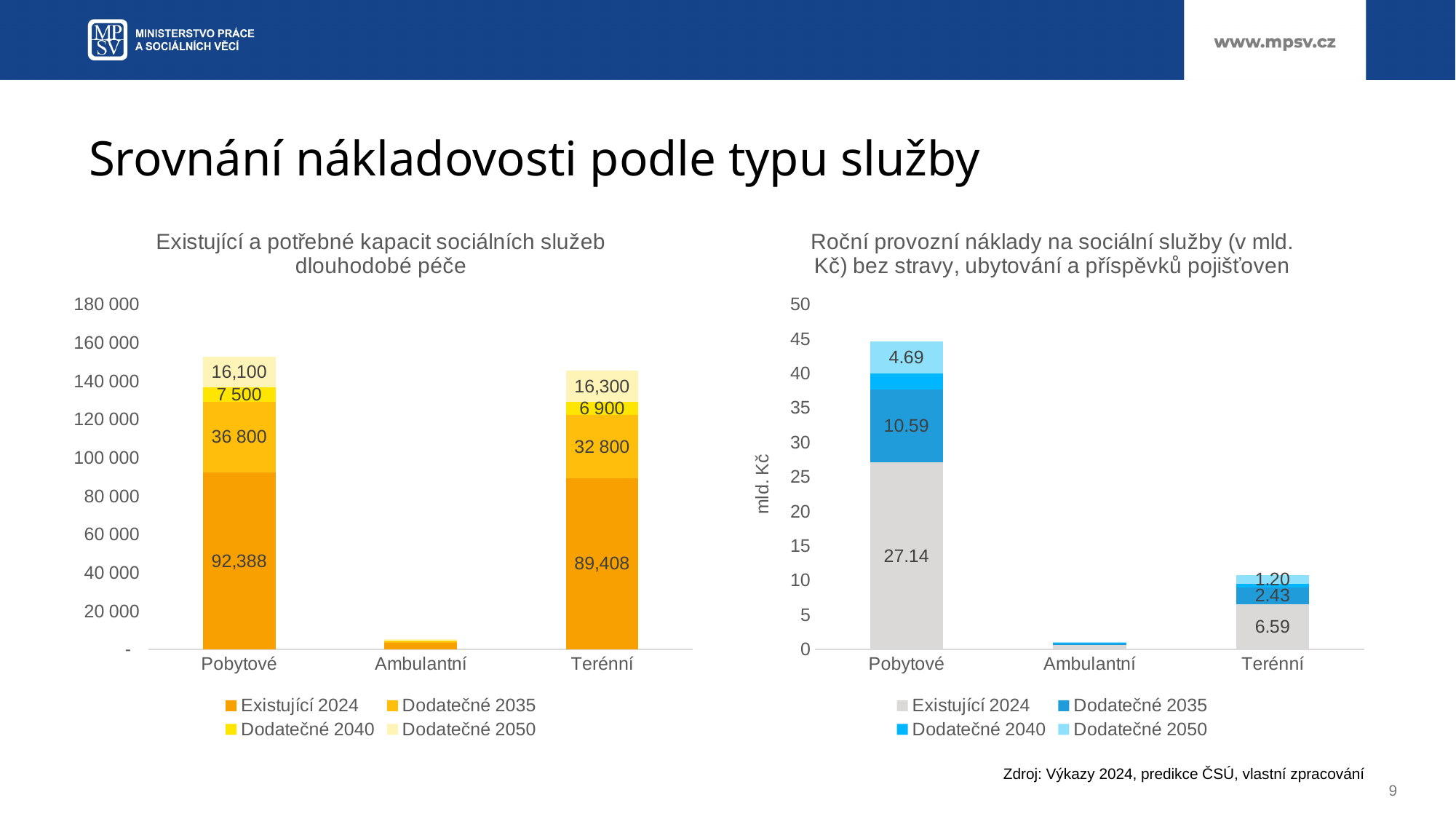
What type of chart is the left chart (Existující a potřebné kapacit sociálních služeb dlouhodobé péče)? Stacked bar chart In the left chart (Existující a potřebné kapacit sociálních služeb dlouhodobé péče), is the total value for Ambulantní greater or less than 20 000? less In the right chart (Roční provozní náklady na sociální služby), what is the difference between the Existující 2024 values for Pobytové and Terénní? 20.55 How many series does the legend of the right chart (Roční provozní náklady na sociální služby) list? 4 In the left chart (Existující a potřebné kapacit sociálních služeb dlouhodobé péče), what is the difference between the Dodatečné 2035 values for Pobytové and Terénní? 4 000 In the left chart (Existující a potřebné kapacit sociálních služeb dlouhodobé péče), what is the Dodatečné 2050 value for Terénní? 16,300 In the right chart (Roční provozní náklady na sociální služby), what is the Existující 2024 value for Pobytové? 27.14 In the left chart (Existující a potřebné kapacit sociálních služeb dlouhodobé péče), which category has the lowest total? Ambulantní In the left chart (Existující a potřebné kapacit sociálních služeb dlouhodobé péče), what is the Existující 2024 value for Pobytové? 92,388 In the right chart (Roční provozní náklady na sociální služby), is the total value for Ambulantní greater or less than 5? less In the left chart (Existující a potřebné kapacit sociálních služeb dlouhodobé péče), what is the total of the stacked bar for Pobytové? 152,788 In the right chart (Roční provozní náklady na sociální služby), what is the Dodatečné 2035 value for Terénní? 2.43